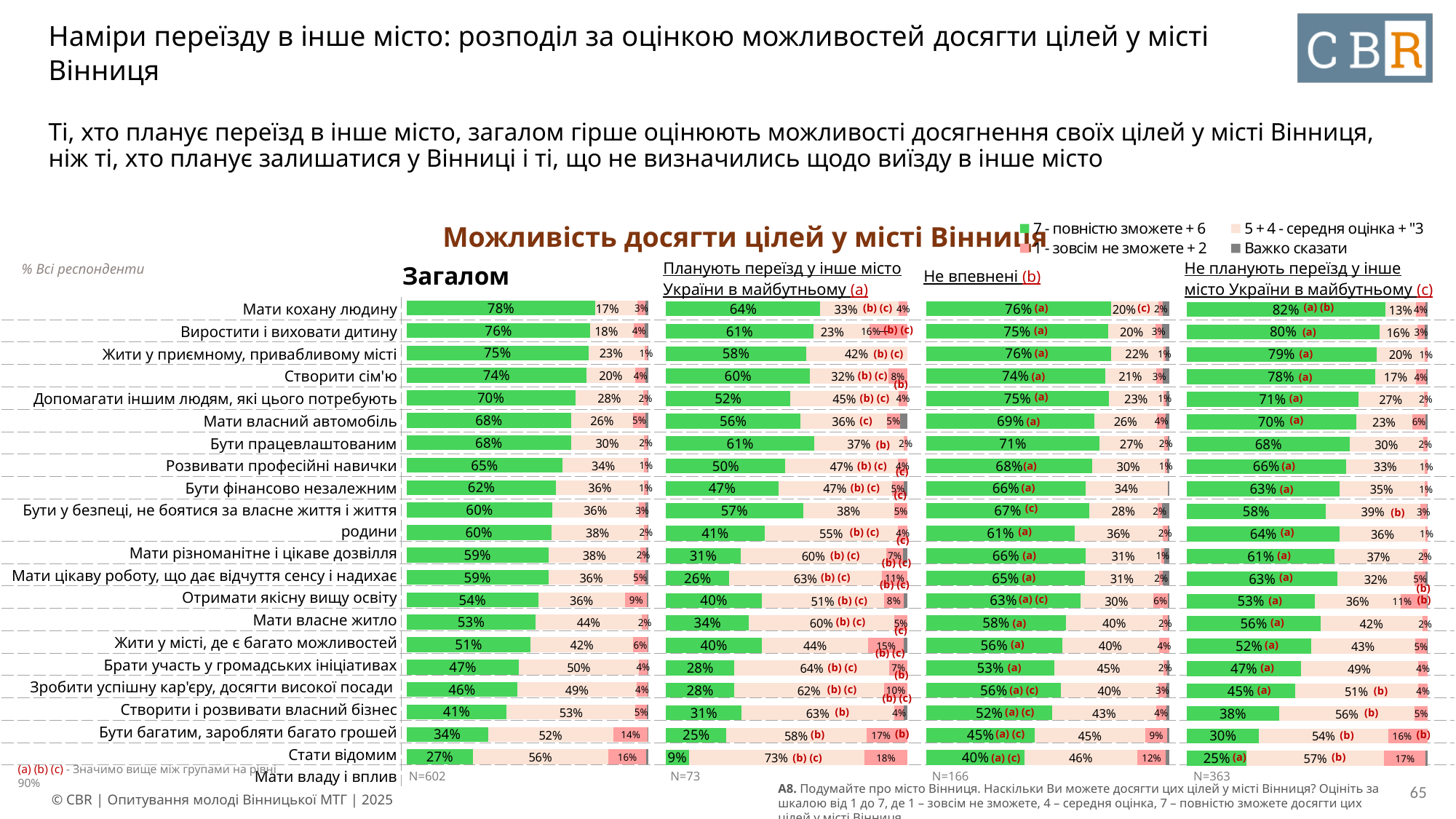
On the "Планують переїзд у інше місто України в майбутньому (a)" chart, what is the green segment value for "Мати кохану людину"? 64% On the "Загалом" chart, which category has the highest green "7 - повністю зможете + 6" value? Мати кохану людину What is the sample size (N) shown under the "Планують переїзд у інше місто України в майбутньому (a)" chart? N=73 On the "Загалом" chart, what is the value of the light "5 + 4 - середня оцінка" segment for "Мати власний автомобіль"? 26% How many series does the legend list for the charts on this slide? 4 On the "Загалом" chart, what is the value of the green "7 - повністю зможете + 6" segment for "Мати кохану людину"? 78% On the "Загалом" chart, what is the difference in percentage points between the green segment for "Мати кохану людину" and the green segment for "Бути працевлаштованим"? 10 percentage points What type of chart is used on this slide? Stacked bar chart On the "Планують переїзд у інше місто України в майбутньому (a)" chart, which has the larger green segment: "Мати кохану людину" or "Створити сім'ю"? Мати кохану людину On the "Не планують переїзд у інше місто України в майбутньому (c)" chart, what is the green segment value for "Мати власний автомобіль"? 70% On the "Не впевнені (b)" chart, what is the green segment value for "Виростити і виховати дитину"? 75% On the "Не планують переїзд у інше місто України в майбутньому (c)" chart, what is the green segment value for "Жити у приємному, привабливому місті"? 79%